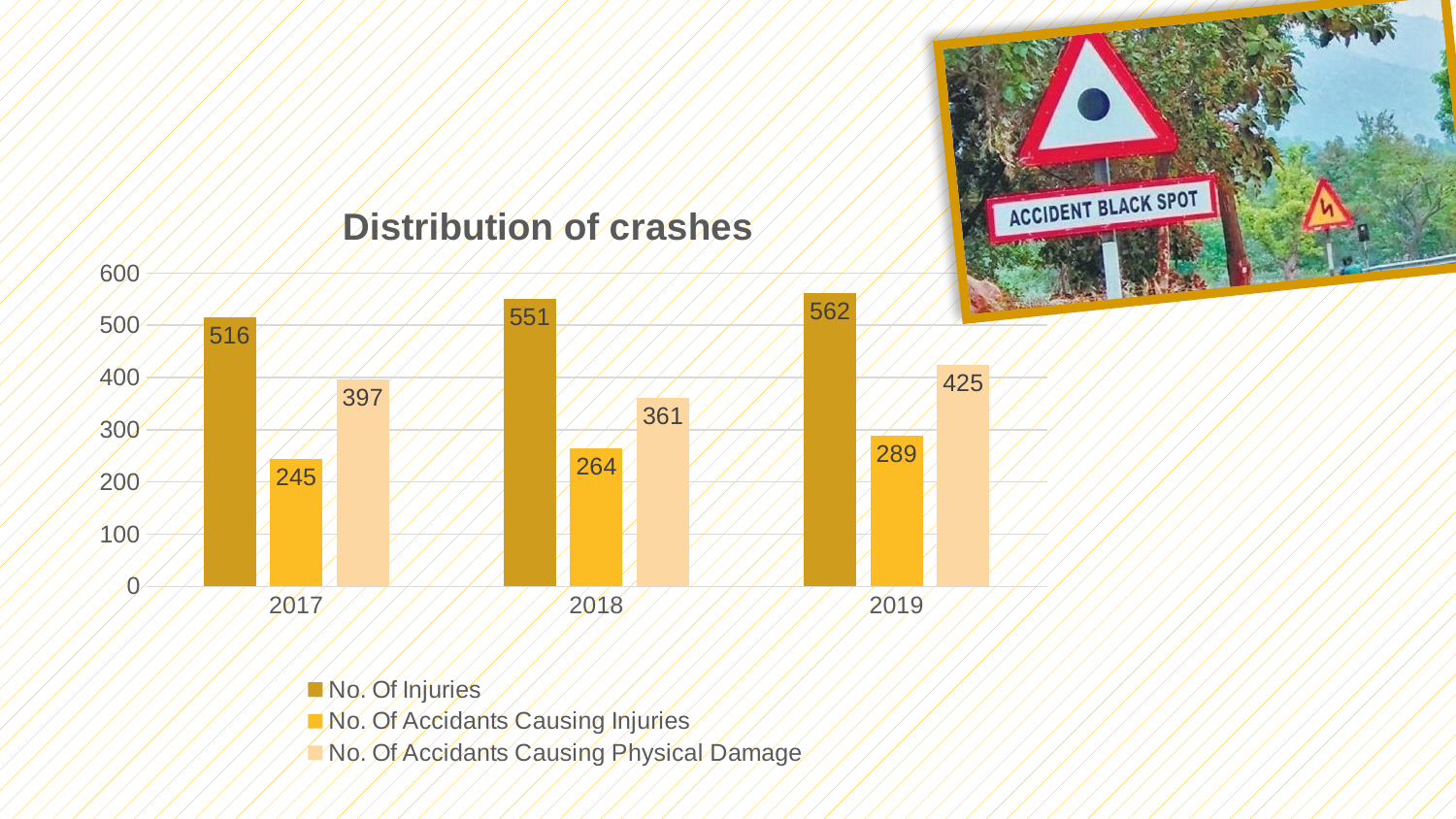
How many series does the legend list? 3 Which is larger in 2018: the number of accidents causing injuries or the number of accidents causing physical damage? No. Of Accidants Causing Physical Damage How many years are shown on the x axis? 3 What is the number of accidents causing physical damage in 2019? 425 What is the number of accidents causing injuries in 2018? 264 What is the difference between accidents causing physical damage and accidents causing injuries in 2019? 136 What is the number of injuries in 2017? 516 Which year has the highest number of injuries? 2019 What is the difference between the number of injuries in 2019 and in 2017? 46 Which year has the lowest number of accidents causing physical damage? 2018 Does the number of accidents causing injuries rise or fall from 2017 to 2019? Rise What kind of chart is shown? Bar chart